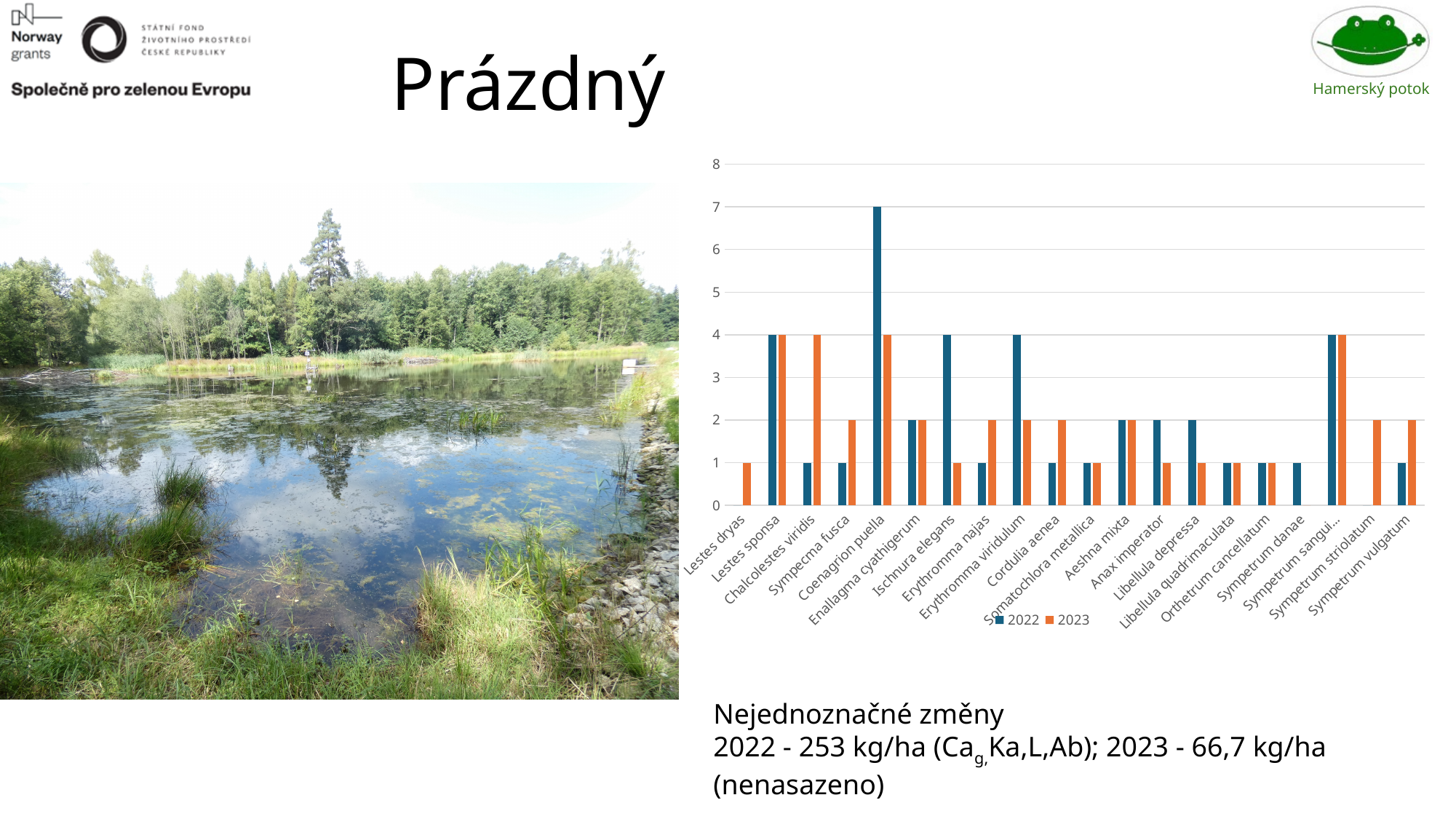
Which category has the highest 2022 value in the chart? Coenagrion puella How many series does the chart legend list? 2 What is the 2022 value for Ischnura elegans? 4 What is the 2023 value for Sympetrum striolatum? 2 For Erythromma viridulum, which is larger: the 2022 value or the 2023 value? 2022 What type of chart is shown on the slide? bar chart Which series are listed in the chart legend? 2022 and 2023 What is the difference between the 2022 and 2023 values for Coenagrion puella? 3 Is the 2022 value for Coenagrion puella greater or less than 5? greater What is the 2023 value for Chalcolestes viridis? 4 What is the 2022 value for Coenagrion puella? 7 How many species categories are shown on the x axis of the chart? 20